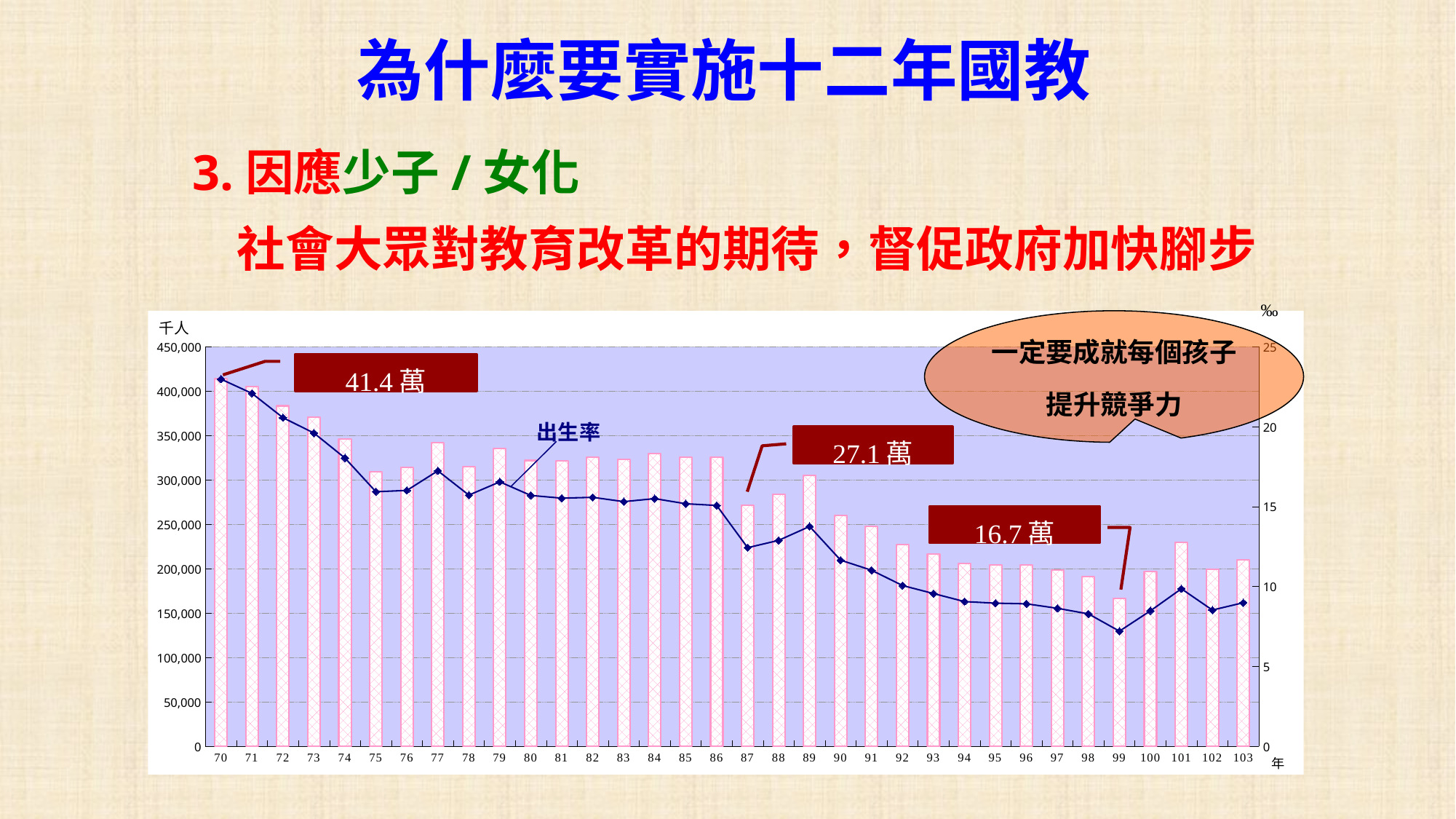
Is the bar for year 101 greater or less than 200,000? greater Is the bar for year 98 greater or less than 200,000? less What is the difference between the annotated values for year 70 and year 99? 24.7 萬 Which year has the tallest bar in the chart? 70 What value is annotated for year 70 in the chart? 41.4 萬 Do the bars generally rise or fall from year 70 to year 103? fall What is the unit label on the left vertical axis of the chart? 千人 Which year has the shortest bar in the chart? 99 What value is annotated for year 87 in the chart? 27.1 萬 What value is annotated for year 99 in the chart? 16.7 萬 Which bar is taller, year 87 or year 101? 87 How many years are shown on the x axis of the chart? 34